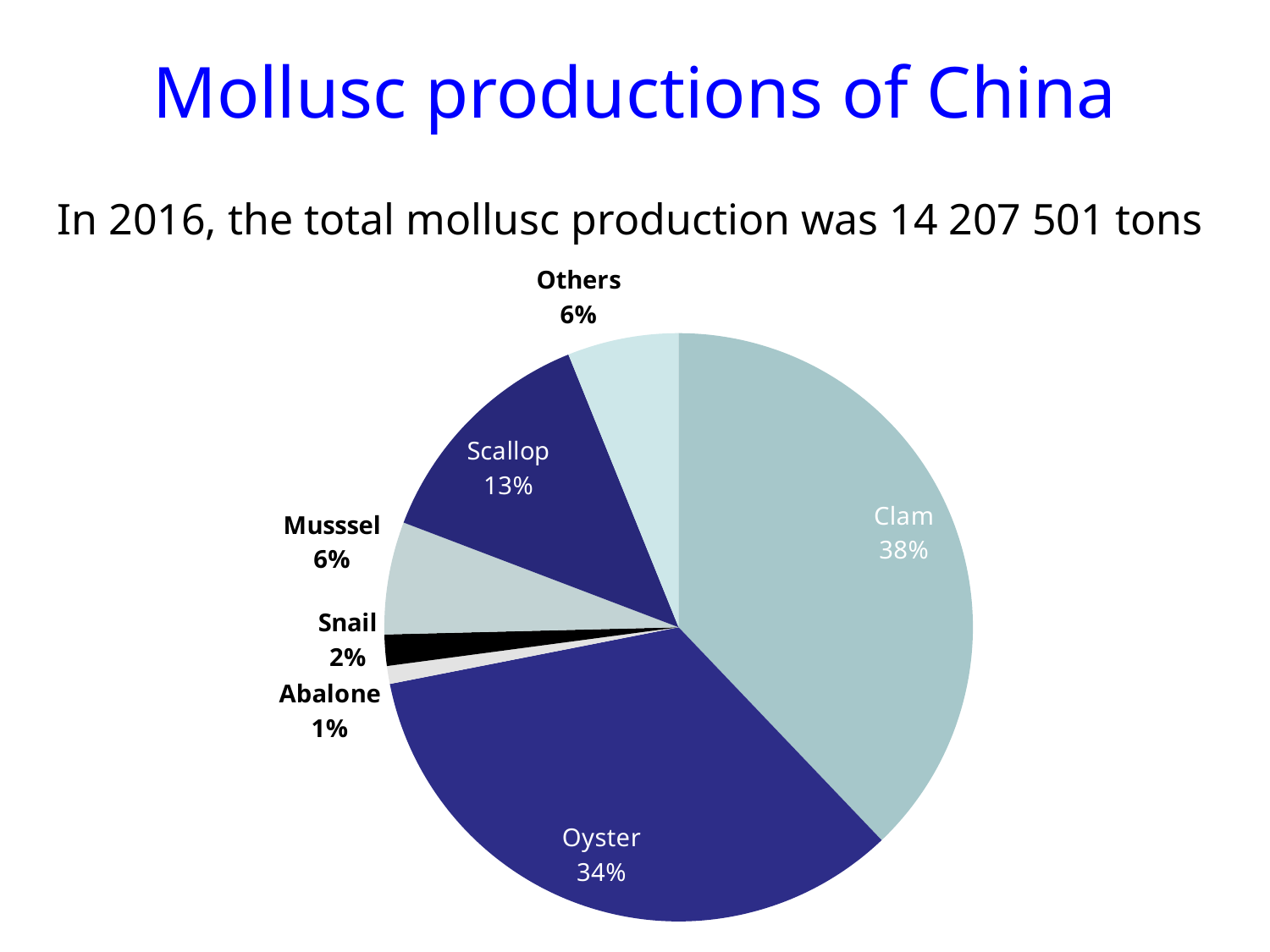
What is the title of the slide containing the chart? Mollusc productions of China Which category has the largest share of the pie? Clam Which category has the smallest share of the pie? Abalone What percentage is shown for Abalone? 1% How many slices does the pie chart have? 7 What is the difference in percentage points between Clam and Oyster? 4 What is the difference in percentage points between Scallop and Snail? 11 What share of mollusc production does Clam account for? 38% What kind of chart is shown on the slide? Pie chart Which is larger, the share for Scallop or the share for Musssel? Scallop What share of mollusc production does Oyster account for? 34% What percentage is shown for Scallop? 13%